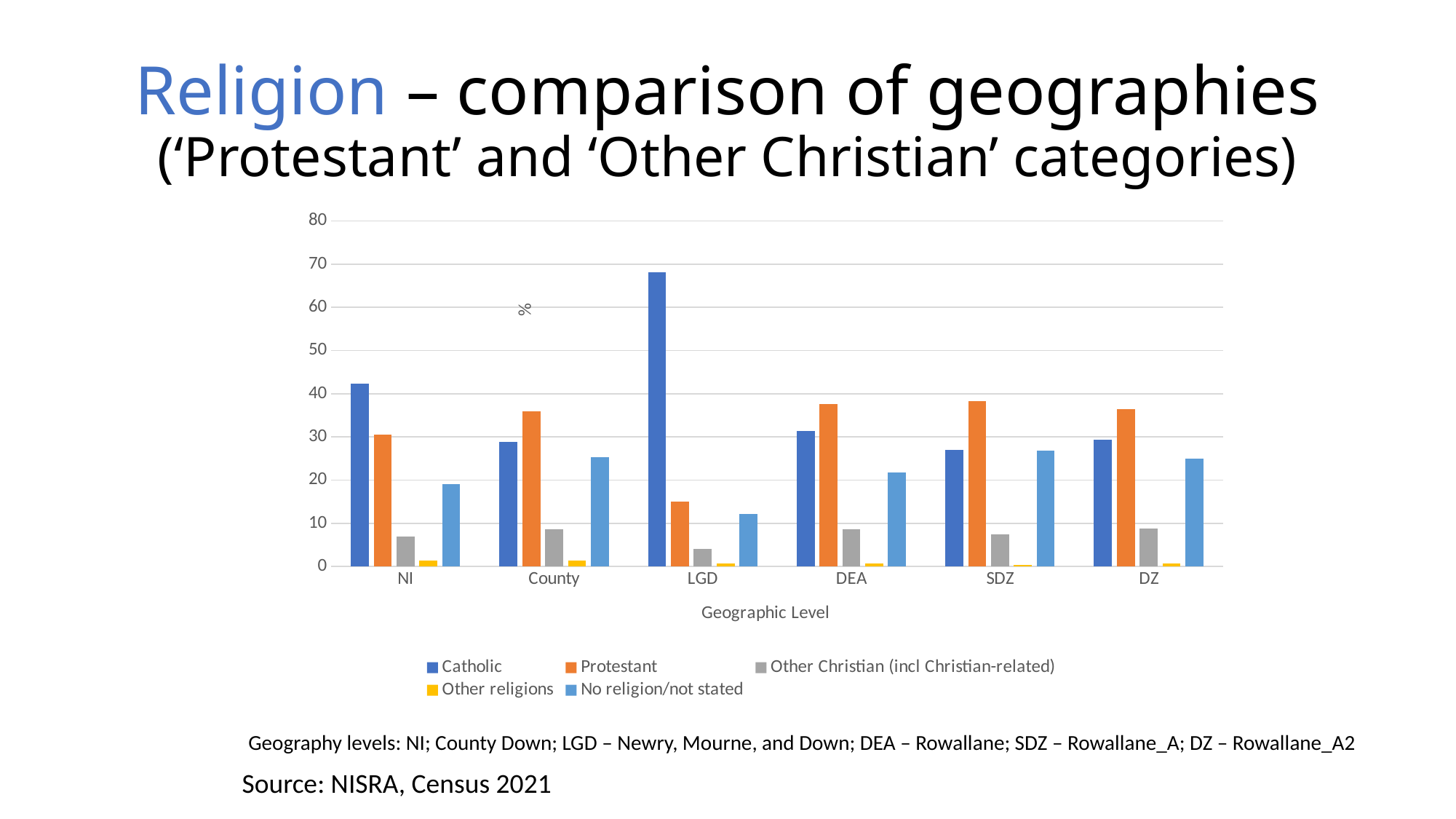
For NI, which is larger: the Catholic value or the Protestant value? Catholic Is the Catholic value for LGD greater or less than 60? greater Which geographic level has the lowest Protestant value? LGD What is the title of the chart's x axis? Geographic Level For DEA, which is larger: the Catholic value or the Protestant value? Protestant Which geographic level has the lowest 'No religion/not stated' value? LGD Is the Protestant value for County greater or less than 30? greater How many series does the chart's legend list? 5 Is the 'No religion/not stated' value for LGD greater or less than 20? less What kind of chart is shown on the slide? bar chart How many geographic levels are shown on the x axis of the chart? 6 Which geographic level has the highest Catholic value? LGD